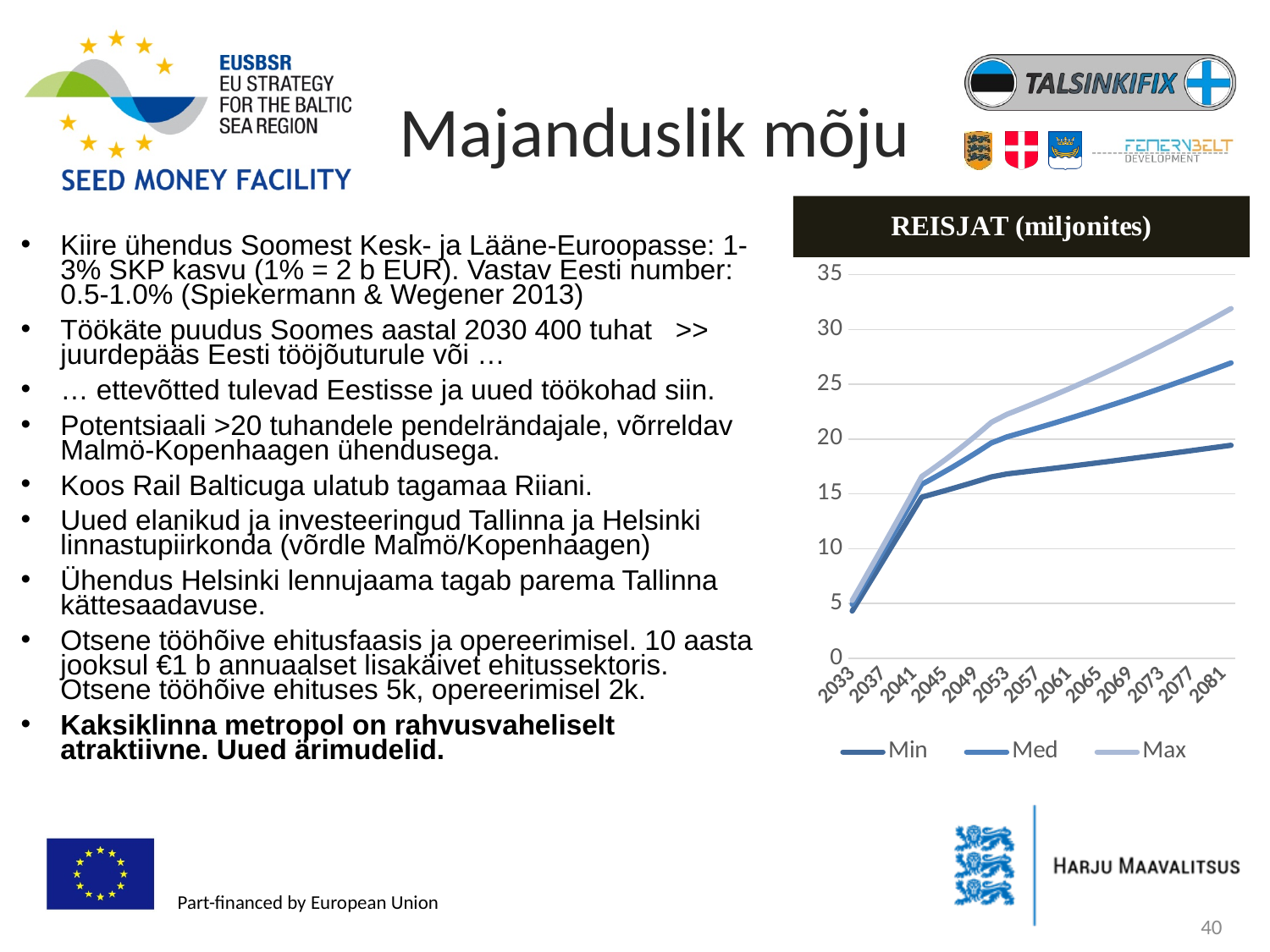
How many year labels are shown on the x axis of the chart? 13 Which series has the highest value in 2081? Max Is the value for the Max series in 2081 greater or less than 30? greater Do the values of the Max series rise or fall from 2033 to 2081? rise Is the value for the Med series in 2081 greater or less than 25? greater What kind of chart is shown on the slide? line chart What is the title of the chart? REISJAT (miljonites) Is the value for the Min series in 2053 greater or less than 20? less Which series has the lowest value in 2081? Min How many series does the chart legend list? 3 Which series are listed in the chart legend? Min, Med, Max In 2081, which is larger: the Max series value or the Min series value? Max